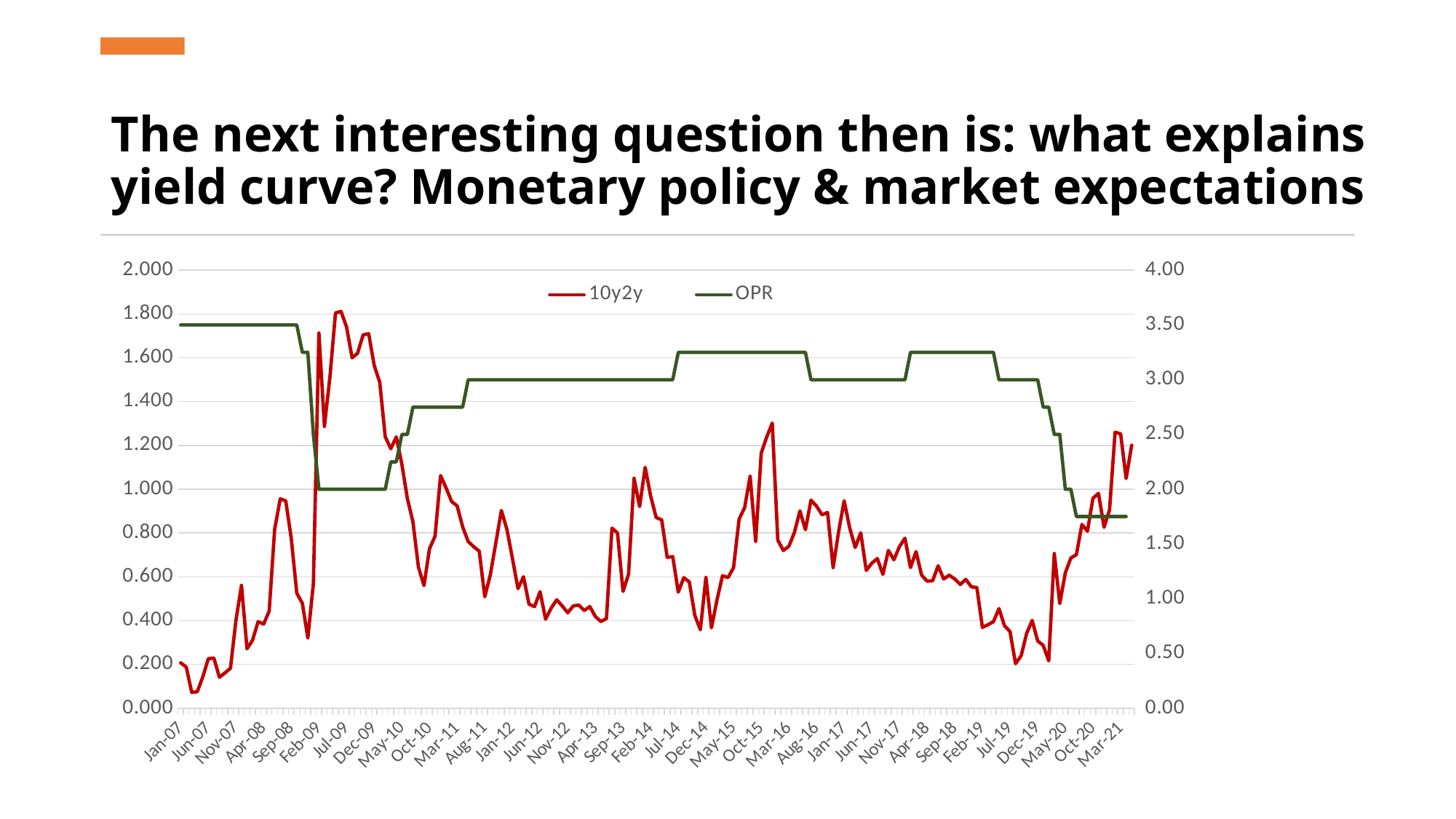
How many series does the legend list? 2 Is the OPR value at Oct-15 greater or less than 3.00? greater What kind of chart is shown on the slide? line chart Is the OPR value at Mar-21 greater or less than 2.00? less What are the two series named in the legend? 10y2y and OPR Is the 10y2y value at Jul-09 greater or less than 1.600? greater What is the OPR value at Dec-09 on the right axis? 2.00 What colour is the OPR line? green What is the OPR value at Jan-07 on the right axis? 3.50 What is the OPR value at Jan-12 on the right axis? 3.00 Does the OPR line overall rise or fall from Jan-07 to Mar-21? fall